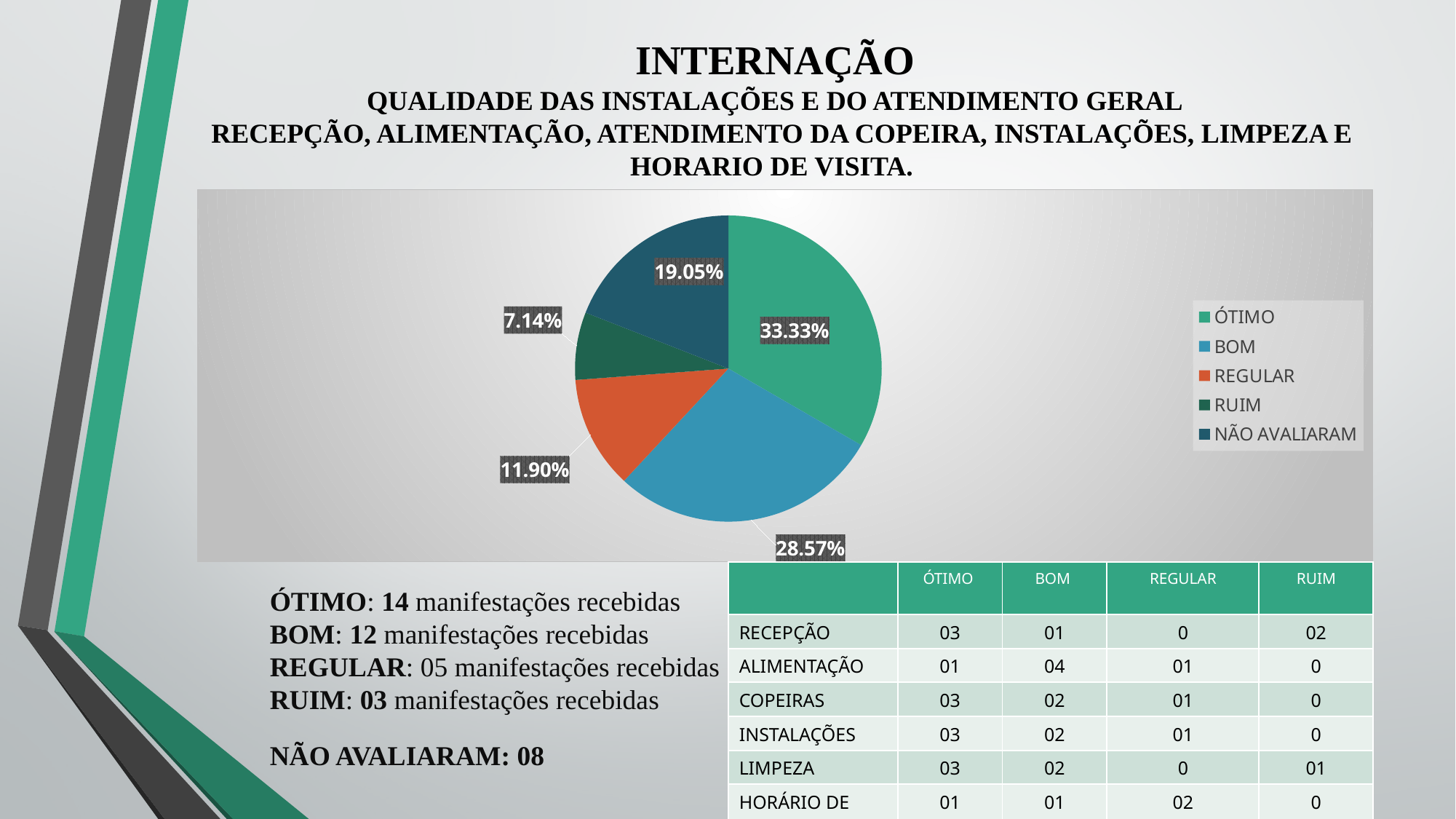
What share of the pie does NÃO AVALIARAM represent? 19.05% How many slices does the pie chart have? 5 What share of the pie does ÓTIMO represent? 33.33% What share of the pie does BOM represent? 28.57% How many entries does the legend list? 5 Which slice is larger, BOM or NÃO AVALIARAM? BOM Which category has the largest slice of the pie? ÓTIMO What is the difference in percentage points between the ÓTIMO and BOM slices? 4.76 Which category has the smallest slice of the pie? RUIM What kind of chart is shown on the slide? pie chart